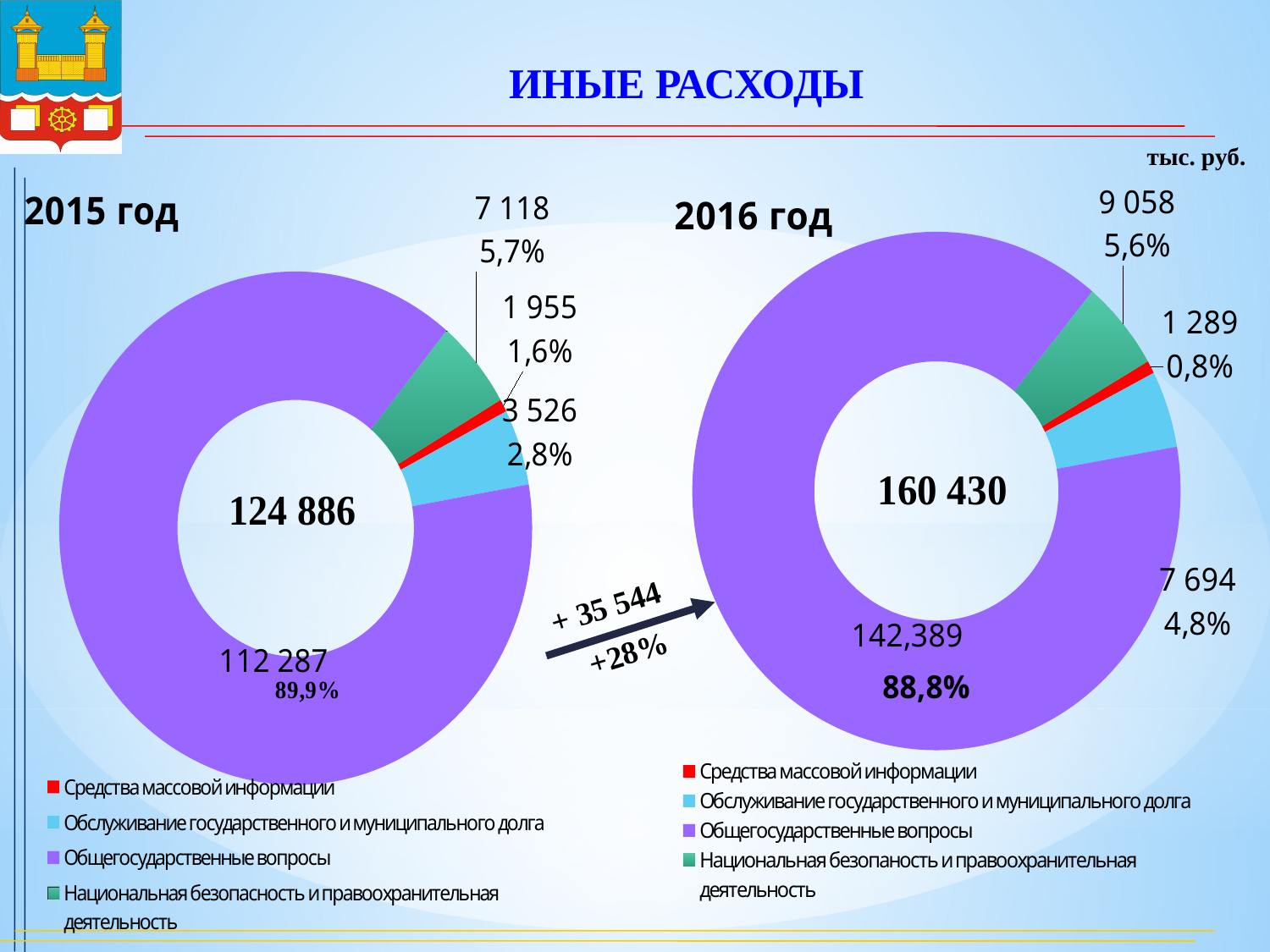
What is the difference between the Национальная безопасность и правоохранительная деятельность values in the 2016 год and 2015 год charts? 1 940 In the 2015 год chart, which category has the smallest value? Средства массовой информации What kind of chart is used for the 2015 год data? doughnut chart In the 2016 год chart, what is the value for Национальная безопасность и правоохранительная деятельность? 9 058 Which is larger: Обслуживание государственного и муниципального долга in 2015 год or in 2016 год? 2016 год How many categories does the legend of the 2015 год chart list? 4 In the 2016 год chart, which category has the largest value? Общегосударственные вопросы What is the total shown in the centre of the 2016 год chart? 160 430 What colour represents Средства массовой информации in both charts? red In the 2015 год chart, what is the value for Общегосударственные вопросы? 112 287 In the 2015 год chart, what share does Обслуживание государственного и муниципального долга have? 2,8% In the 2016 год chart, what share does Средства массовой информации have? 0,8%